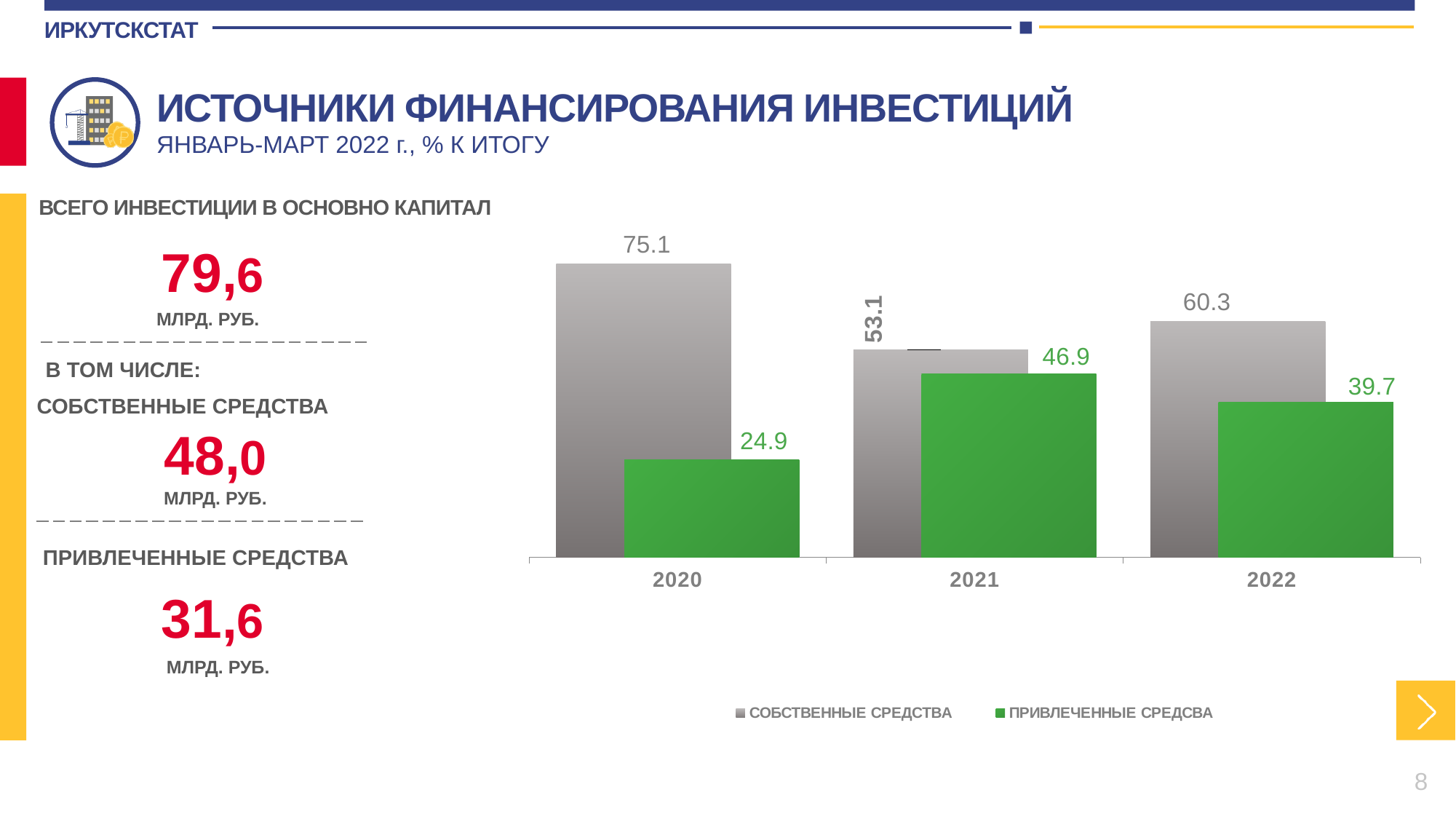
Which is larger in 2021: СОБСТВЕННЫЕ СРЕДСТВА or ПРИВЛЕЧЕННЫЕ СРЕДСВА? СОБСТВЕННЫЕ СРЕДСТВА What is the value for СОБСТВЕННЫЕ СРЕДСТВА in 2020? 75.1 What is the value for ПРИВЛЕЧЕННЫЕ СРЕДСВА in 2022? 39.7 How many series does the chart legend list? 2 In which year is the value for ПРИВЛЕЧЕННЫЕ СРЕДСВА the lowest? 2020 Which colour represents ПРИВЛЕЧЕННЫЕ СРЕДСВА in the chart? Green What is the value for СОБСТВЕННЫЕ СРЕДСТВА in 2022? 60.3 What kind of chart is shown on the slide? Bar chart What is the value for ПРИВЛЕЧЕННЫЕ СРЕДСВА in 2021? 46.9 How many years are shown on the x axis of the chart? 3 In which year is the value for СОБСТВЕННЫЕ СРЕДСТВА the highest? 2020 What is the difference between СОБСТВЕННЫЕ СРЕДСТВА and ПРИВЛЕЧЕННЫЕ СРЕДСВА in 2022? 20.6